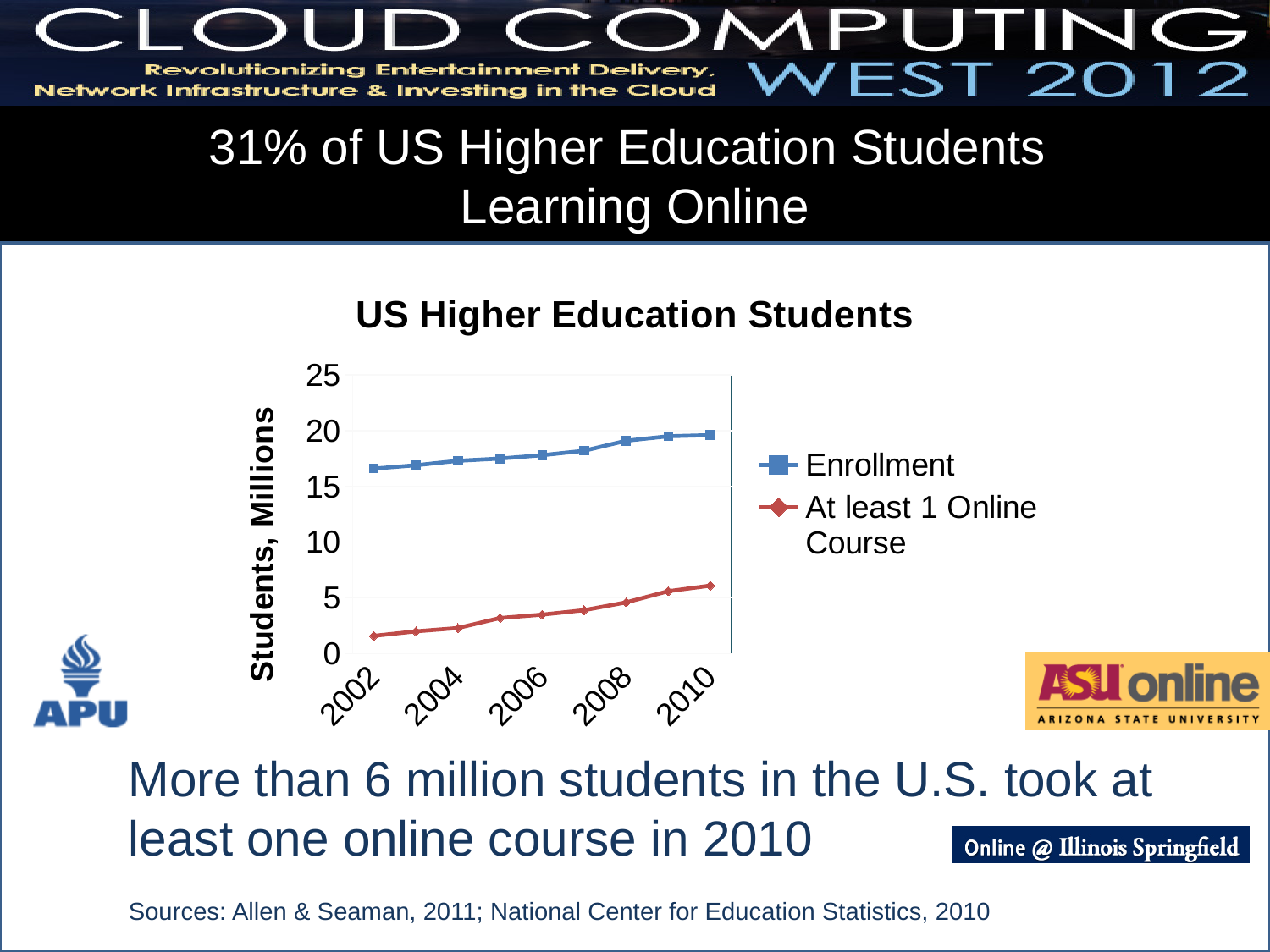
In 2010, which series has the larger value, Enrollment or At least 1 Online Course? Enrollment Is the 'At least 1 Online Course' value for 2010 greater or less than 5? greater How many series does the chart's legend list? 2 Does the 'At least 1 Online Course' series rise or fall from 2002 to 2010? rise What is the title of the chart? US Higher Education Students What kind of chart is shown on the slide? line chart Does the Enrollment series rise or fall from 2002 to 2010? rise Is the Enrollment value for 2002 greater or less than 15? greater What is the label on the chart's vertical axis? Students, Millions Is the 'At least 1 Online Course' value for 2002 greater or less than 5? less